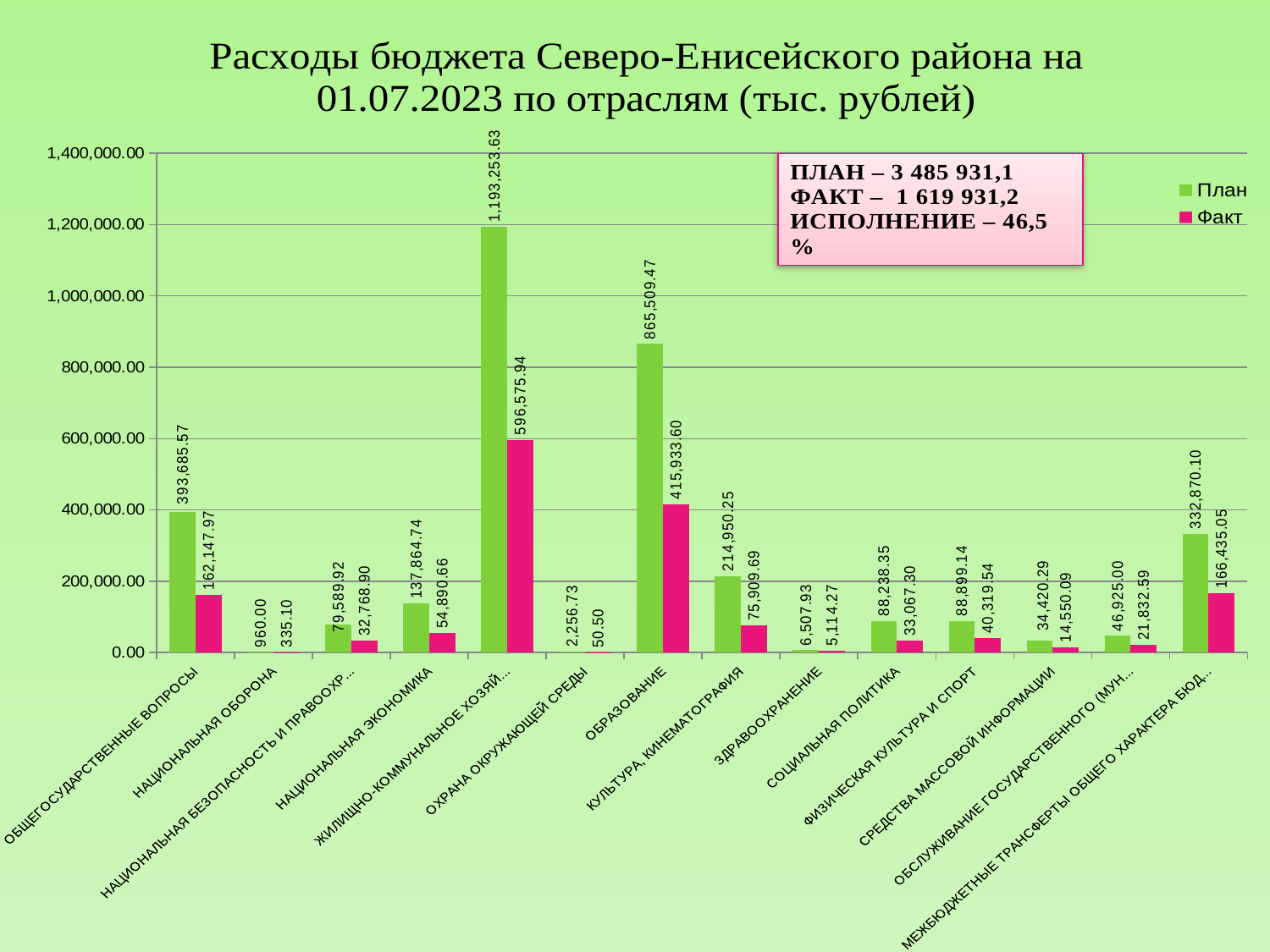
How many series does the legend list? 2 What is the Факт value for ЖИЛИЩНО-КОММУНАЛЬНОЕ ХОЗЯЙ...? 596,575.94 Which category has the lowest Факт value? ОХРАНА ОКРУЖАЮЩЕЙ СРЕДЫ Is the Факт value for ОБЩЕГОСУДАРСТВЕННЫЕ ВОПРОСЫ greater or less than 200,000.00? less What kind of chart is shown on the slide? bar chart What is the difference between the План and Факт values for ЗДРАВООХРАНЕНИЕ? 1,393.66 What is the План value for ОБРАЗОВАНИЕ? 865,509.47 What is the difference between the План and Факт values for ОБРАЗОВАНИЕ? 449,575.87 How many categories are shown on the x axis? 14 What is the Факт value for НАЦИОНАЛЬНАЯ ОБОРОНА? 335.10 Which is larger: the План value for ОБЩЕГОСУДАРСТВЕННЫЕ ВОПРОСЫ or the План value for МЕЖБЮДЖЕТНЫЕ ТРАНСФЕРТЫ ОБЩЕГО ХАРАКТЕРА БЮД...? ОБЩЕГОСУДАРСТВЕННЫЕ ВОПРОСЫ Which category has the highest План value? ЖИЛИЩНО-КОММУНАЛЬНОЕ ХОЗЯЙ...